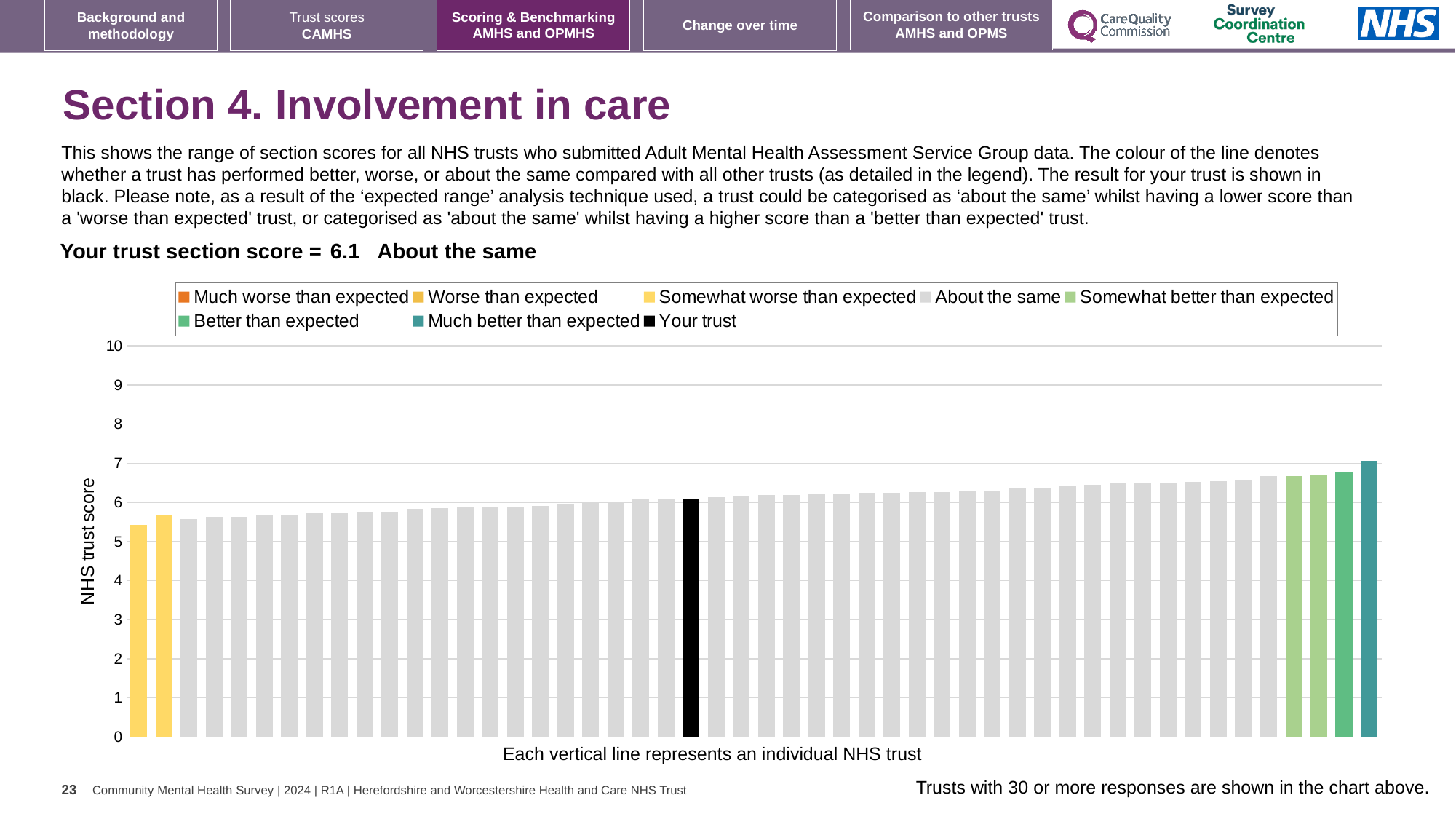
What is the section score for your trust shown on the slide? 6.1 Which category is your trust placed in for this section? About the same What kind of chart is shown on the slide? bar chart Is the value of the rightmost bar greater or less than 6? greater Which is larger, the leftmost bar or the rightmost bar? the rightmost bar Do the bar values rise or fall from left to right along the x axis? rise Is the value for your trust (the black bar) greater or less than 5? greater Is the value of the leftmost bar greater or less than 6? less How many bars are coloured as 'Worse than expected'? 0 What is the label on the y axis of the chart? NHS trust score How many bars are coloured as 'Much better than expected'? 1 How many entries does the chart legend list? 8